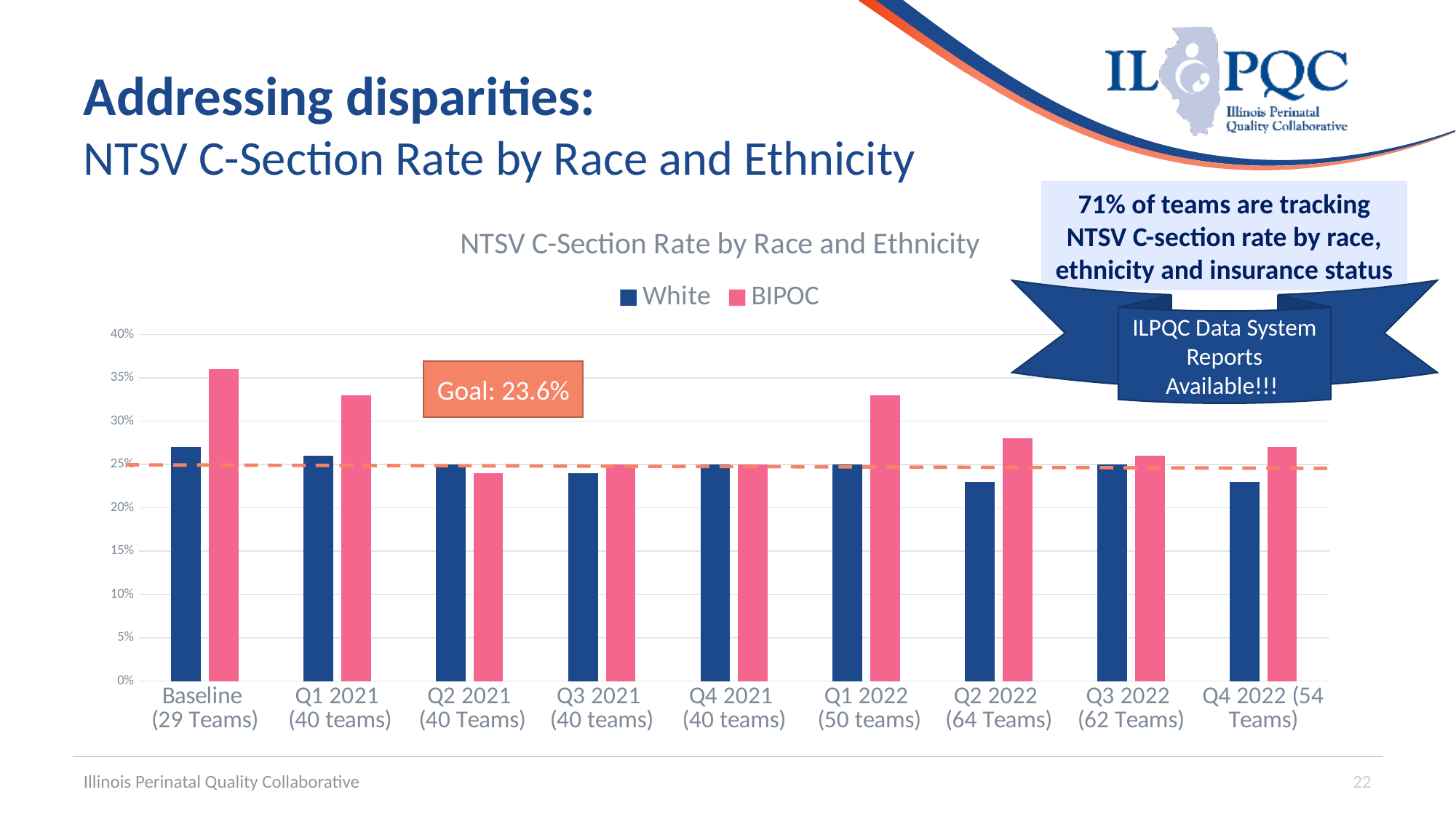
Is the White value for Q2 2022 (64 Teams) greater or less than 25%? less What kind of chart is shown on the slide? Bar chart Is the BIPOC value for Q1 2022 (50 teams) greater or less than 30%? greater For Q4 2022 (54 Teams), which is larger, the White value or the BIPOC value? BIPOC How many categories are shown along the x axis? 9 What goal value is shown on the chart? 23.6% How many series does the legend list? 2 For Q1 2022 (50 teams), which is larger, the White value or the BIPOC value? BIPOC Is the BIPOC value for Baseline (29 Teams) greater or less than 30%? greater What is the title of the chart? NTSV C-Section Rate by Race and Ethnicity Which category has the highest BIPOC value? Baseline (29 Teams)